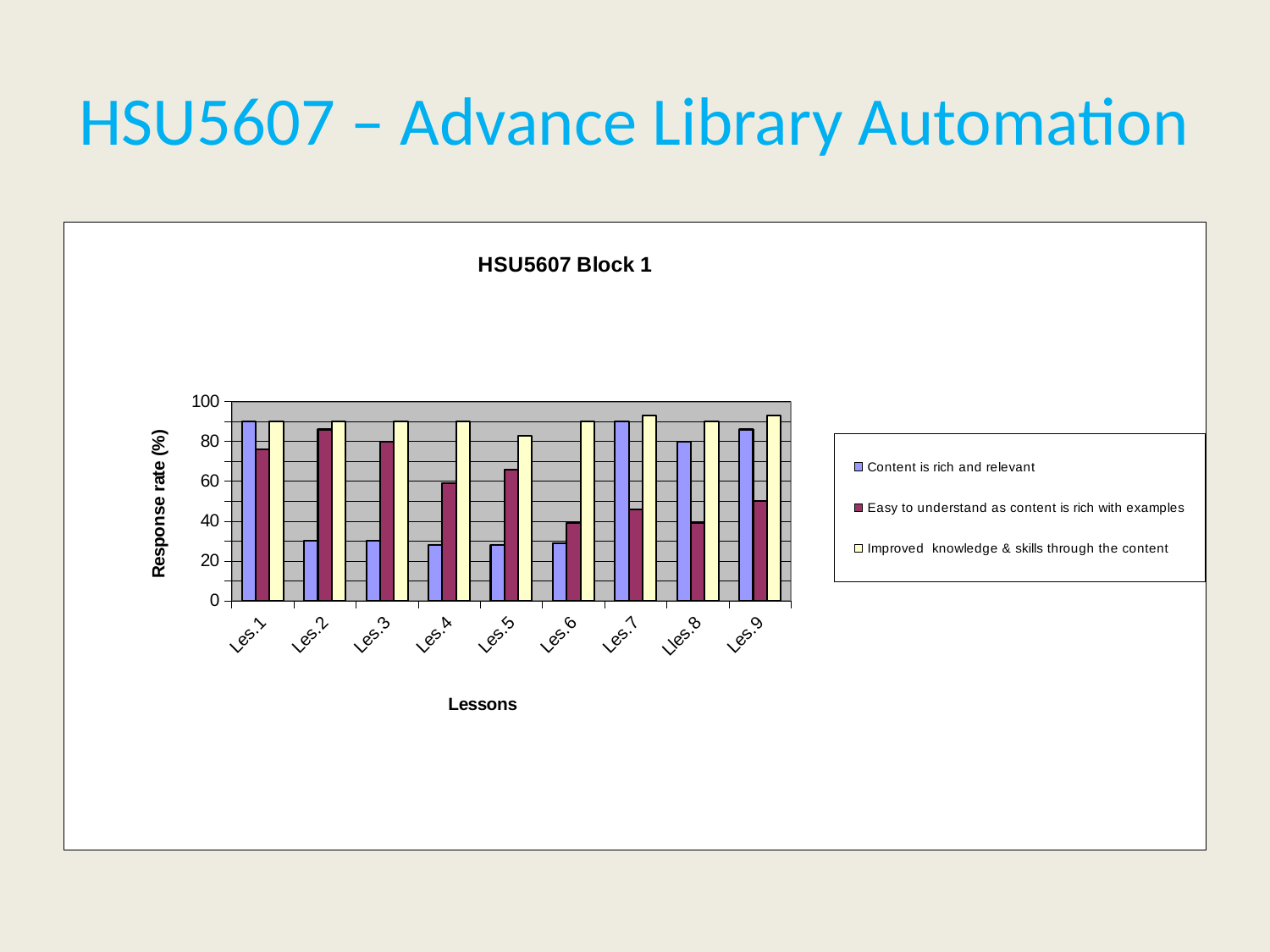
What is the label of the vertical axis of the chart? Response rate (%) What kind of chart is shown on the slide? bar chart What is the title of the chart? HSU5607 Block 1 Which is larger at Les.7: 'Content is rich and relevant' or 'Easy to understand as content is rich with examples'? Content is rich and relevant How many series does the legend of the chart list? 3 Is the value for 'Easy to understand as content is rich with examples' at Les.4 greater or less than 40? greater Is the value for 'Content is rich and relevant' at Les.2 greater or less than 40? less Is the value for 'Easy to understand as content is rich with examples' at Les.6 greater or less than 60? less Which is larger at Les.3: 'Content is rich and relevant' or 'Easy to understand as content is rich with examples'? Easy to understand as content is rich with examples How many lessons are shown along the x axis of the chart? 9